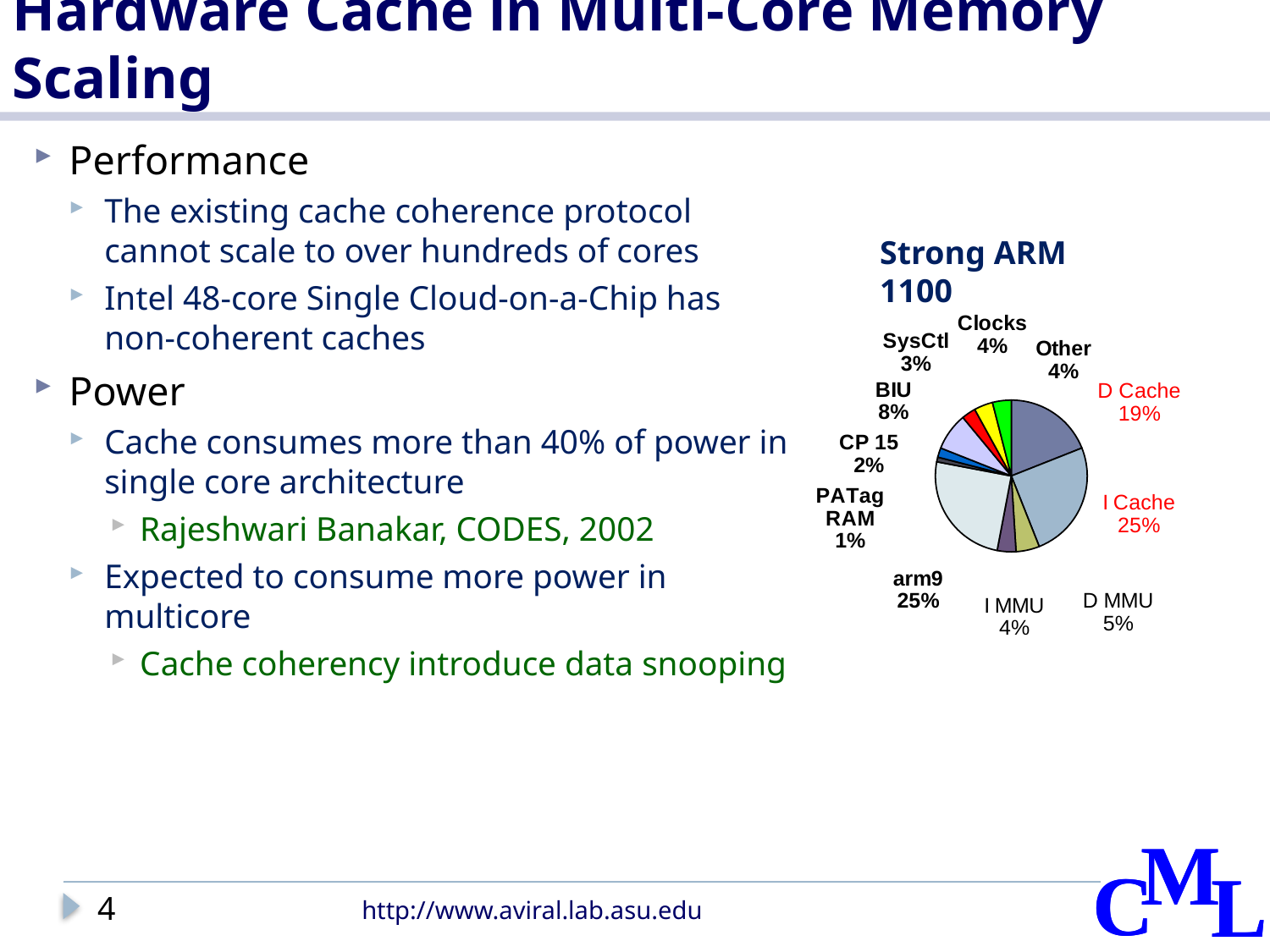
What is the title of the pie chart? Strong ARM 1100 Which is larger, the share for BIU or the share for SysCtl? BIU What is the difference between the I Cache and D Cache shares? 6% Which slice of the pie is the smallest? PATag RAM What is the value shown for CP 15? 2% What is the value shown for BIU? 8% What share of the pie does I Cache account for? 25% What type of chart is shown on the slide? pie chart How many slices does the pie chart have? 11 What share of the pie does D Cache account for? 19% What is the combined share of D Cache and I Cache? 44% What is the value shown for D MMU? 5%